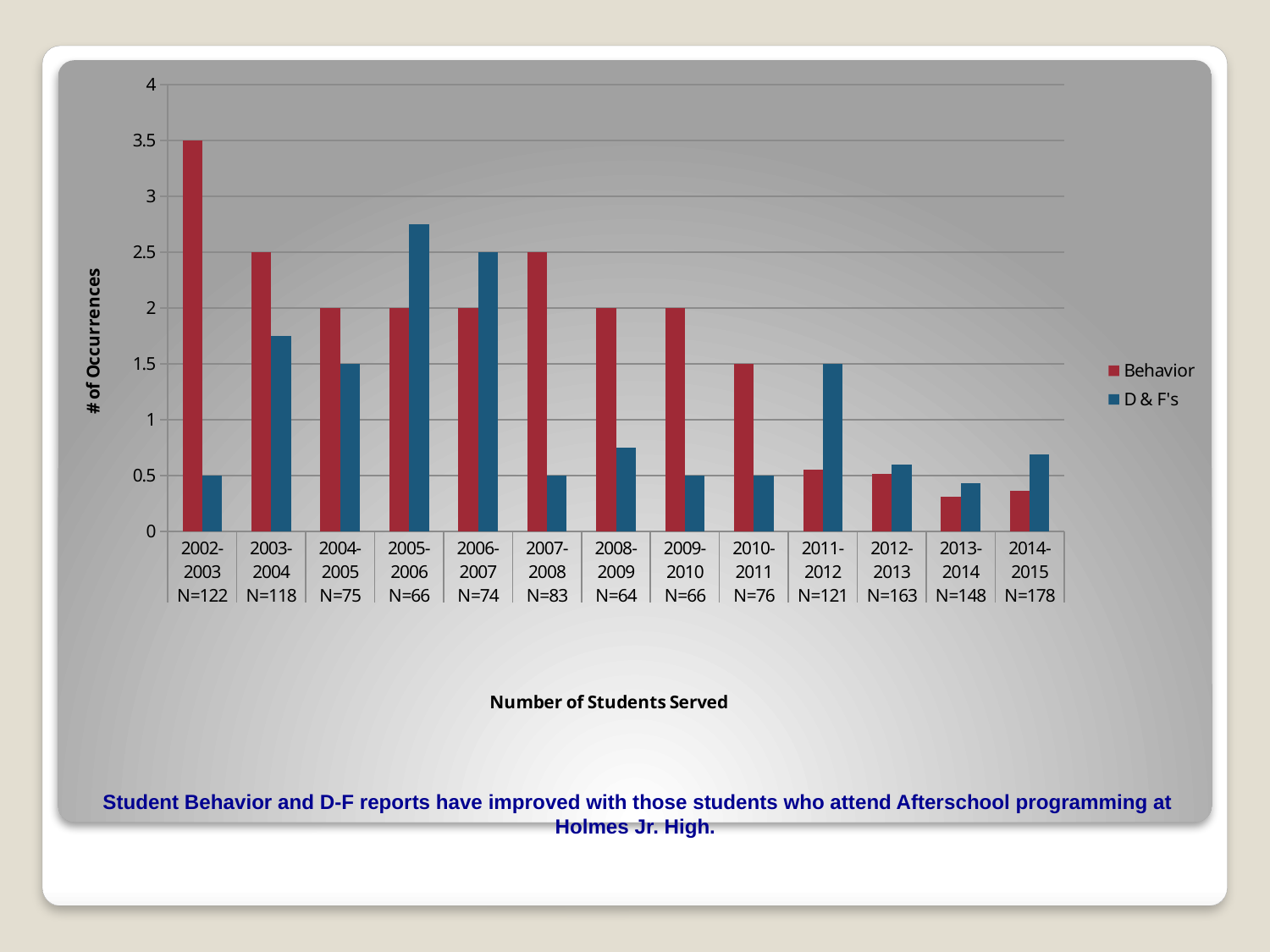
What is the D & F's value for 2006-2007 N=74? 2.5 What is the difference between the Behavior and D & F's values for 2002-2003 N=122? 3 What is the Behavior value for 2010-2011 N=76? 1.5 How many school years are shown on the x axis? 13 What is the title of the vertical axis? # of Occurrences Is the D & F's value for 2005-2006 N=66 greater or less than 2.5? greater Is the Behavior value for 2011-2012 N=121 greater or less than 1? less For 2005-2006 N=66, which series has the larger value, Behavior or D & F's? D & F's Which school year has the highest D & F's value? 2005-2006 N=66 How many series does the legend list? 2 What is the Behavior value for 2002-2003 N=122? 3.5 Which school year has the highest Behavior value? 2002-2003 N=122